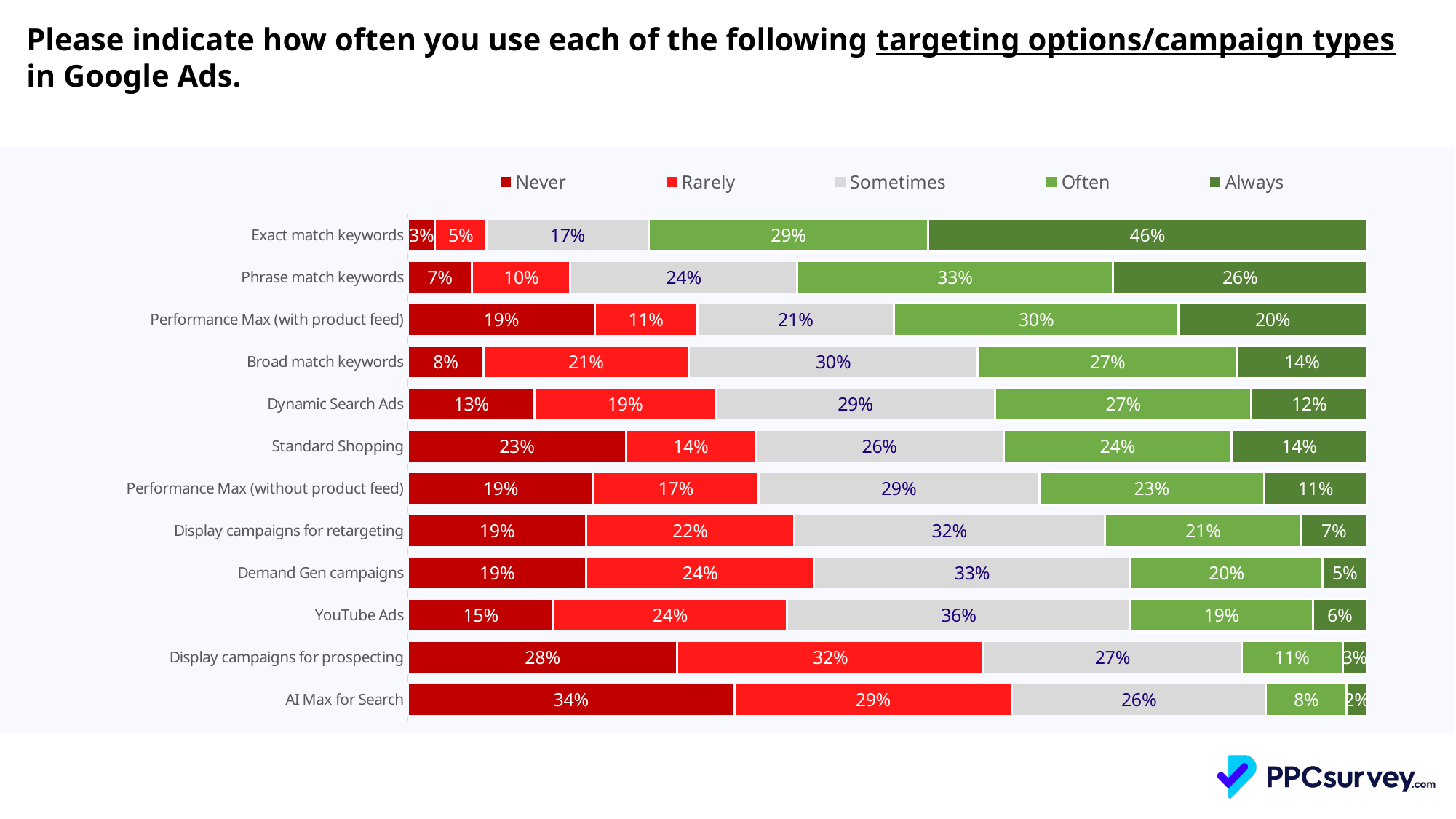
How many series does the legend list? 5 What percentage of respondents say they 'Never' use AI Max for Search? 34% What is the 'Sometimes' value for YouTube Ads? 36% How many targeting options/campaign types are listed in the chart? 12 What percentage of respondents say they 'Always' use Exact match keywords? 46% Which targeting option has the lowest 'Always' percentage? AI Max for Search What kind of chart is shown on the slide? Stacked bar chart Which is larger: the 'Never' value for Standard Shopping or the 'Never' value for Dynamic Search Ads? Standard Shopping What is the difference between the 'Often' values for Phrase match keywords and Broad match keywords? 6% What colour represents the 'Sometimes' category in the chart? Grey What is the 'Rarely' value for Display campaigns for prospecting? 32% Which targeting option has the highest 'Always' percentage? Exact match keywords